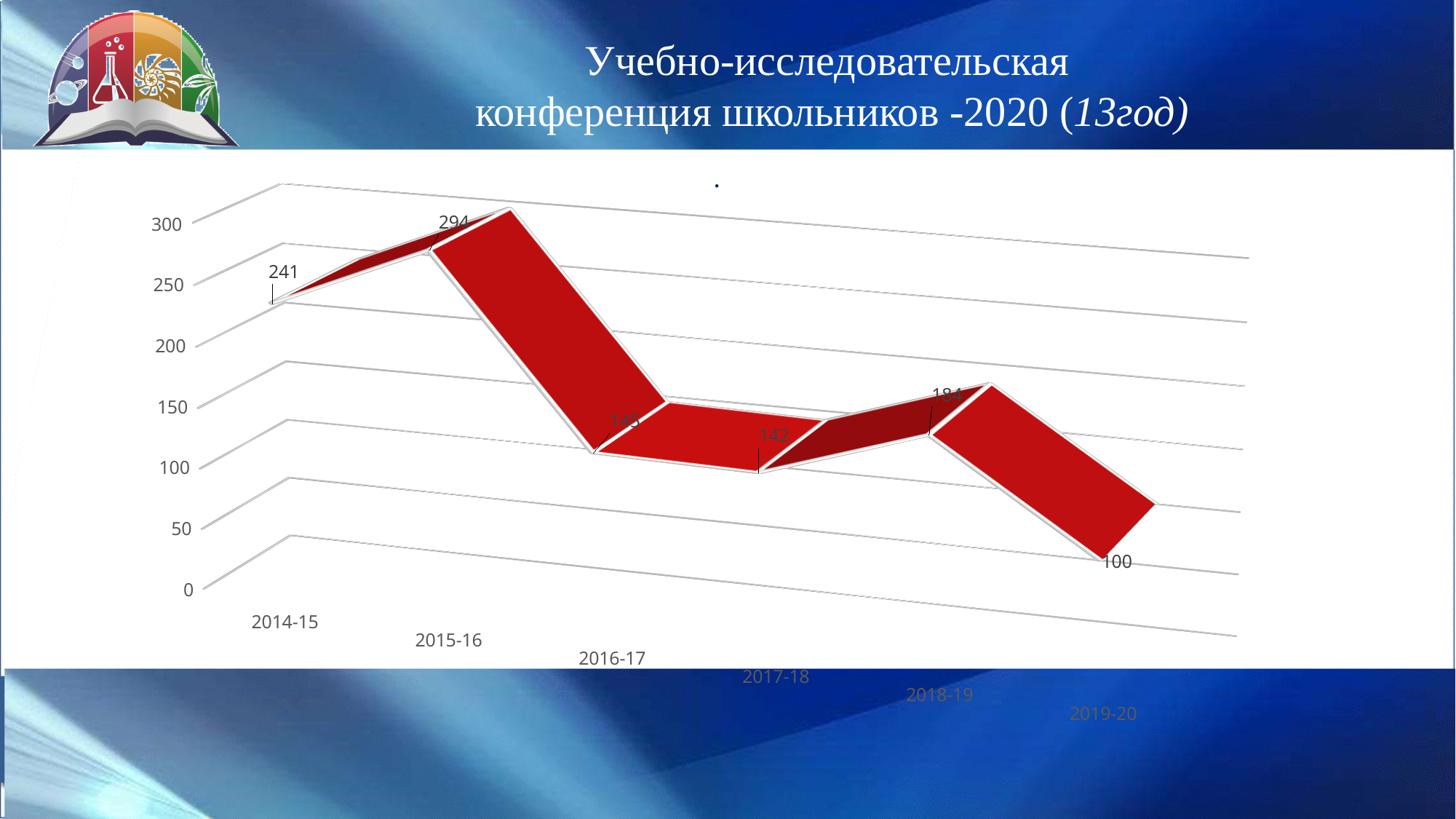
What is the value for 2019-20? 100 Which year has the lowest value? 2019-20 What kind of chart is shown on the slide? line chart Which is larger, the value for 2018-19 or the value for 2017-18? 2018-19 What is the value for 2018-19? 184 What is the value for 2015-16? 294 Does the value rise or fall from 2018-19 to 2019-20? fall What is the difference between the values for 2014-15 and 2019-20? 141 What is the difference between the values for 2015-16 and 2016-17? 149 How many years are plotted on the chart? 6 Which year has the highest value? 2015-16 What is the value for 2014-15? 241